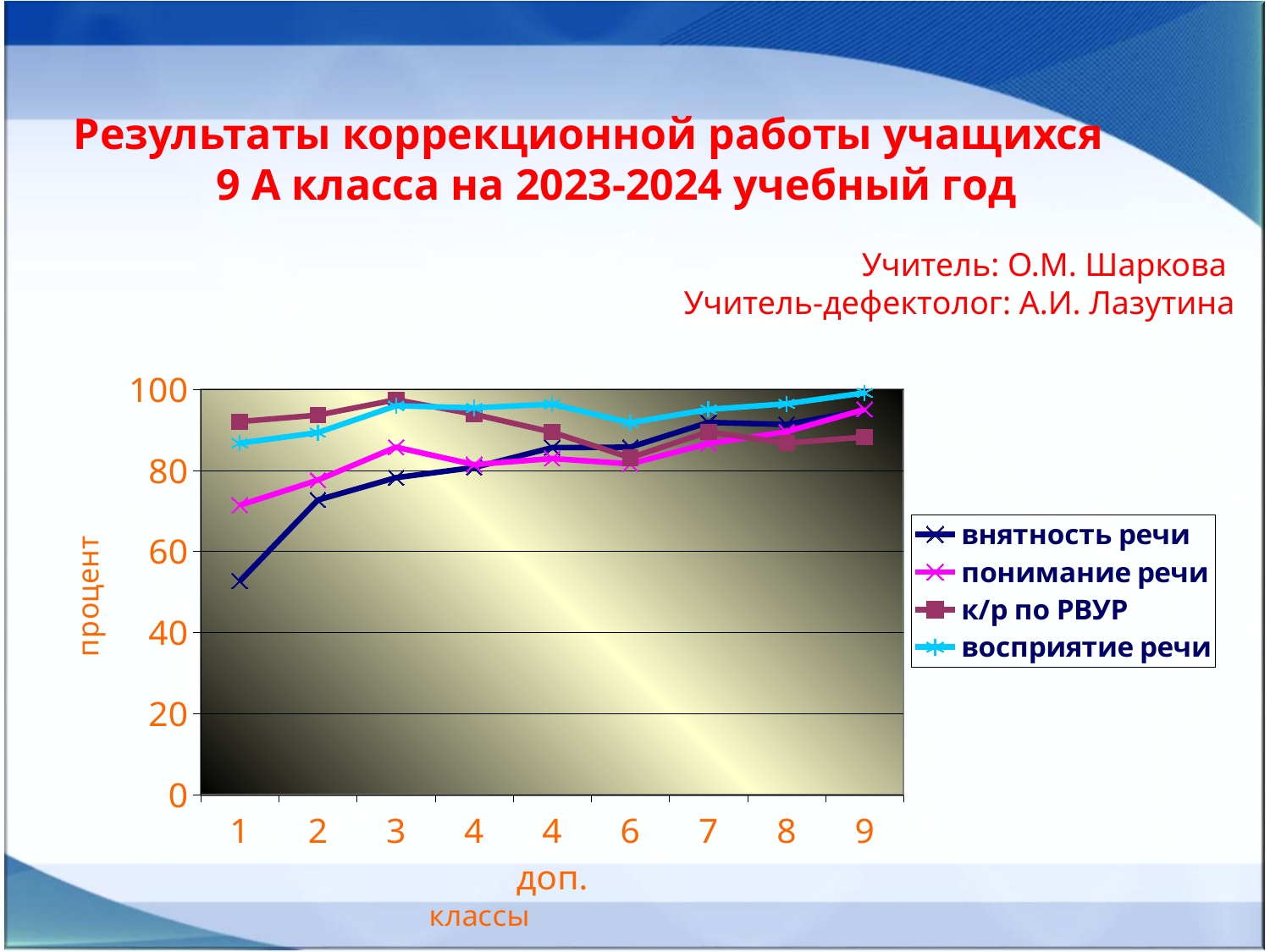
Is the value for внятность речи at category 1 greater or less than 60? less Is the value for к/р по РВУР at category 1 greater or less than 80? greater What kind of chart is shown on the slide? line chart What is the title of the vertical axis? процент Does the внятность речи series generally rise or fall from category 1 to category 9? rise Which series has the lowest value at category 1? внятность речи At category 1, which is larger: к/р по РВУР or внятность речи? к/р по РВУР Is the value for понимание речи at category 1 greater or less than 60? greater At category 3, which is larger: к/р по РВУР or понимание речи? к/р по РВУР How many series does the legend list? 4 How many categories are plotted along the x axis? 9